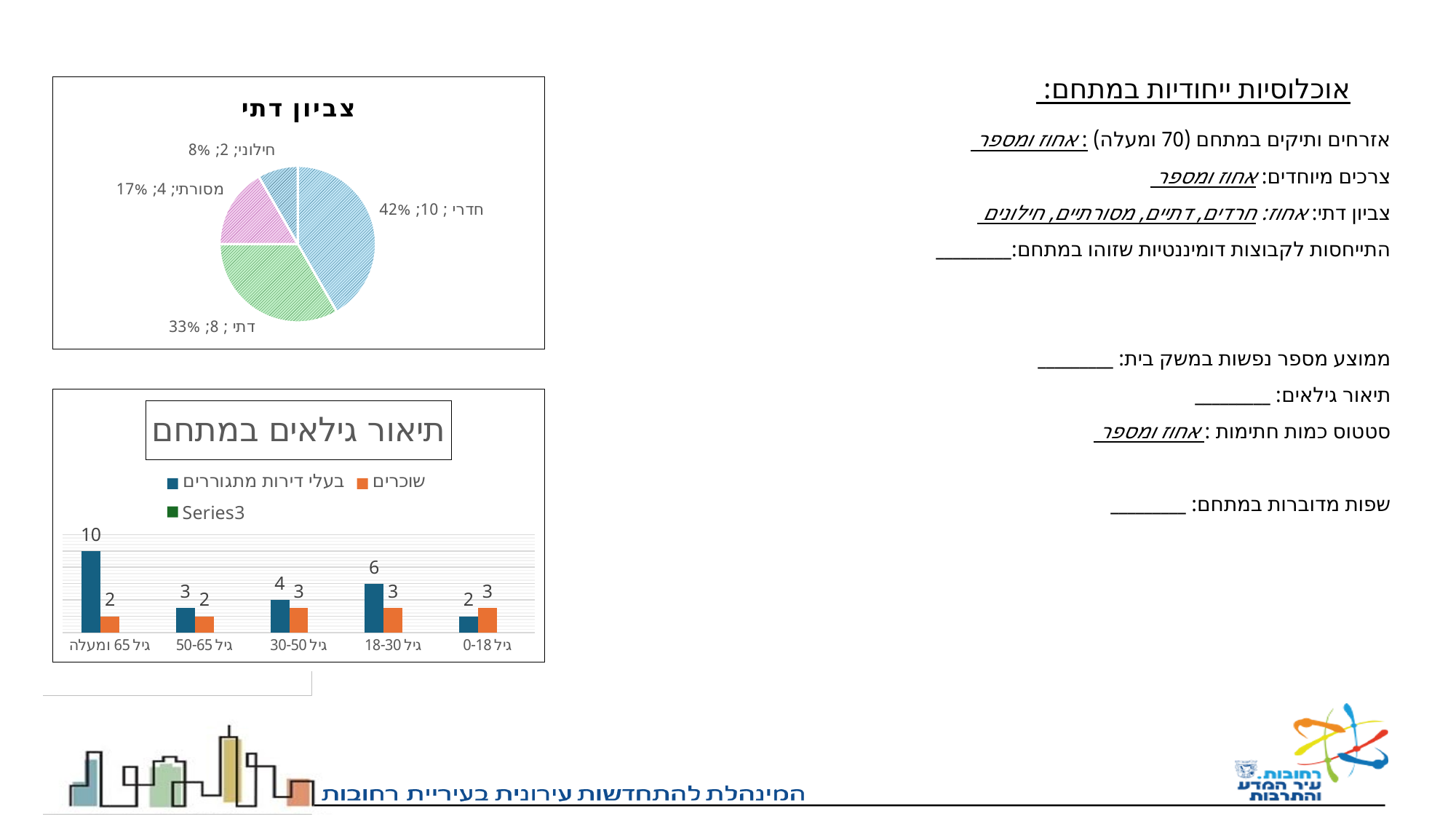
What kind of chart is the chart titled "תיאור גילאים במתחם"? bar chart In the bar chart titled "תיאור גילאים במתחם", which is larger in the "גיל 0-18" category: "בעלי דירות מתגוררים" or "שוכרים"? שוכרים How many slices does the pie chart titled "צביון דתי" have? 4 In the bar chart titled "תיאור גילאים במתחם", which category has the highest value for "בעלי דירות מתגוררים"? גיל 65 ומעלה In the pie chart titled "צביון דתי", which slice has the smallest share? חילוני In the bar chart titled "תיאור גילאים במתחם", how many series does the legend list? 3 In the pie chart titled "צביון דתי", what is the difference in count between the "דתי" and "חילוני" slices? 6 In the pie chart titled "צביון דתי", what percentage is shown for the "חרדי" slice? 42% In the pie chart titled "צביון דתי", what count is shown for the "מסורתי" slice? 4 In the pie chart titled "צביון דתי", which slice has the largest share? חרדי In the bar chart titled "תיאור גילאים במתחם", what is the value for "בעלי דירות מתגוררים" in the "גיל 65 ומעלה" category? 10 In the bar chart titled "תיאור גילאים במתחם", what is the value for "שוכרים" in the "גיל 18-30" category? 3